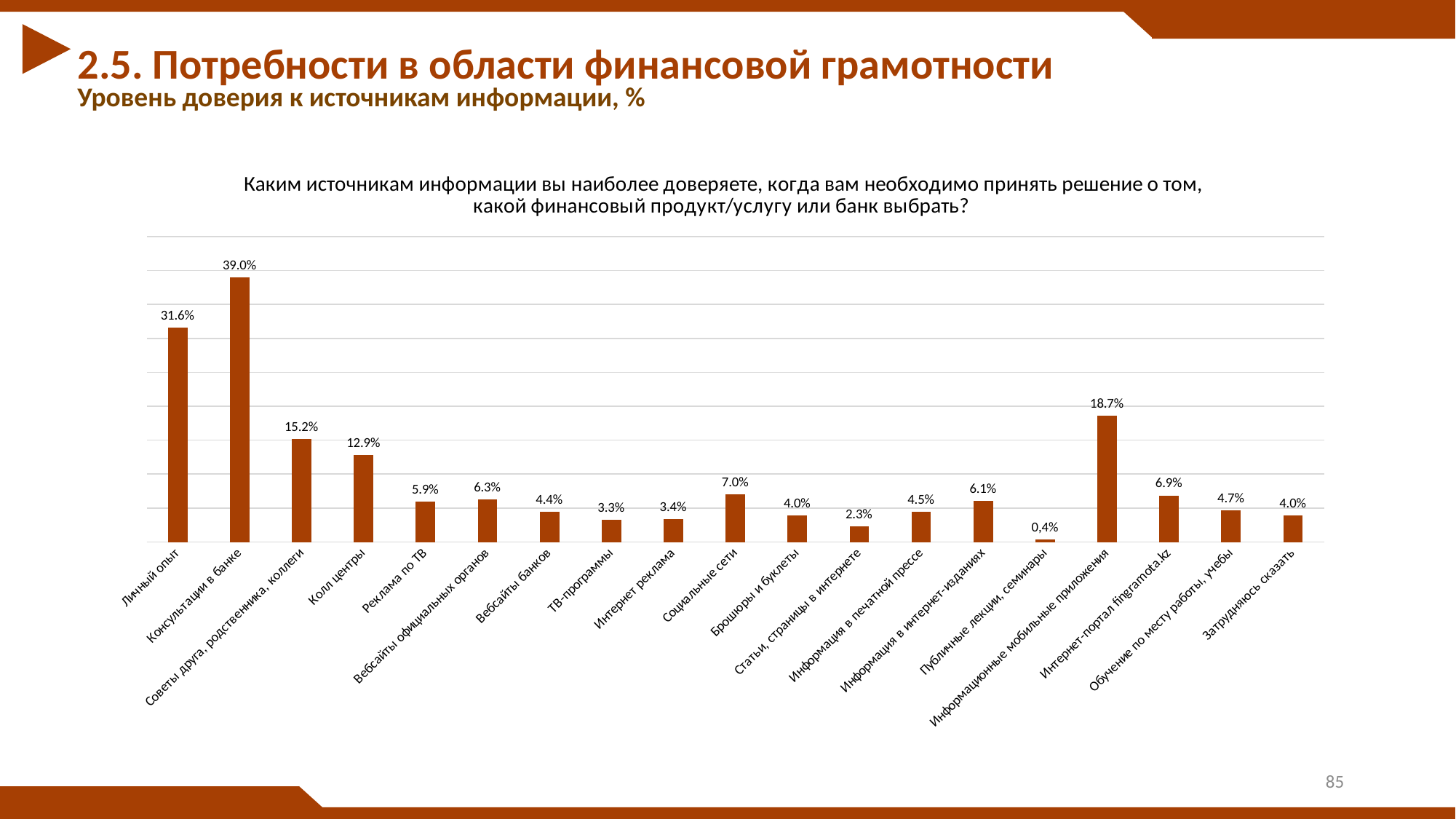
What kind of chart is shown on the slide? Bar chart What value is shown for Информационные мобильные приложения? 18.7% Which is larger, the value for Социальные сети or the value for Вебсайты банков? Социальные сети What value is shown for Консультации в банке? 39.0% What is the difference between the values for Информационные мобильные приложения and Советы друга, родственника, коллеги? 3.5% What is the difference between the values for Консультации в банке and Личный опыт? 7.4% What value is shown for Публичные лекции, семинары? 0,4% What value is shown for Интернет-портал fingramota.kz? 6.9% What colour are the bars in the chart? Brown How many categories are shown on the chart? 19 Which source of information has the highest value? Консультации в банке Which source of information has the lowest value? Публичные лекции, семинары